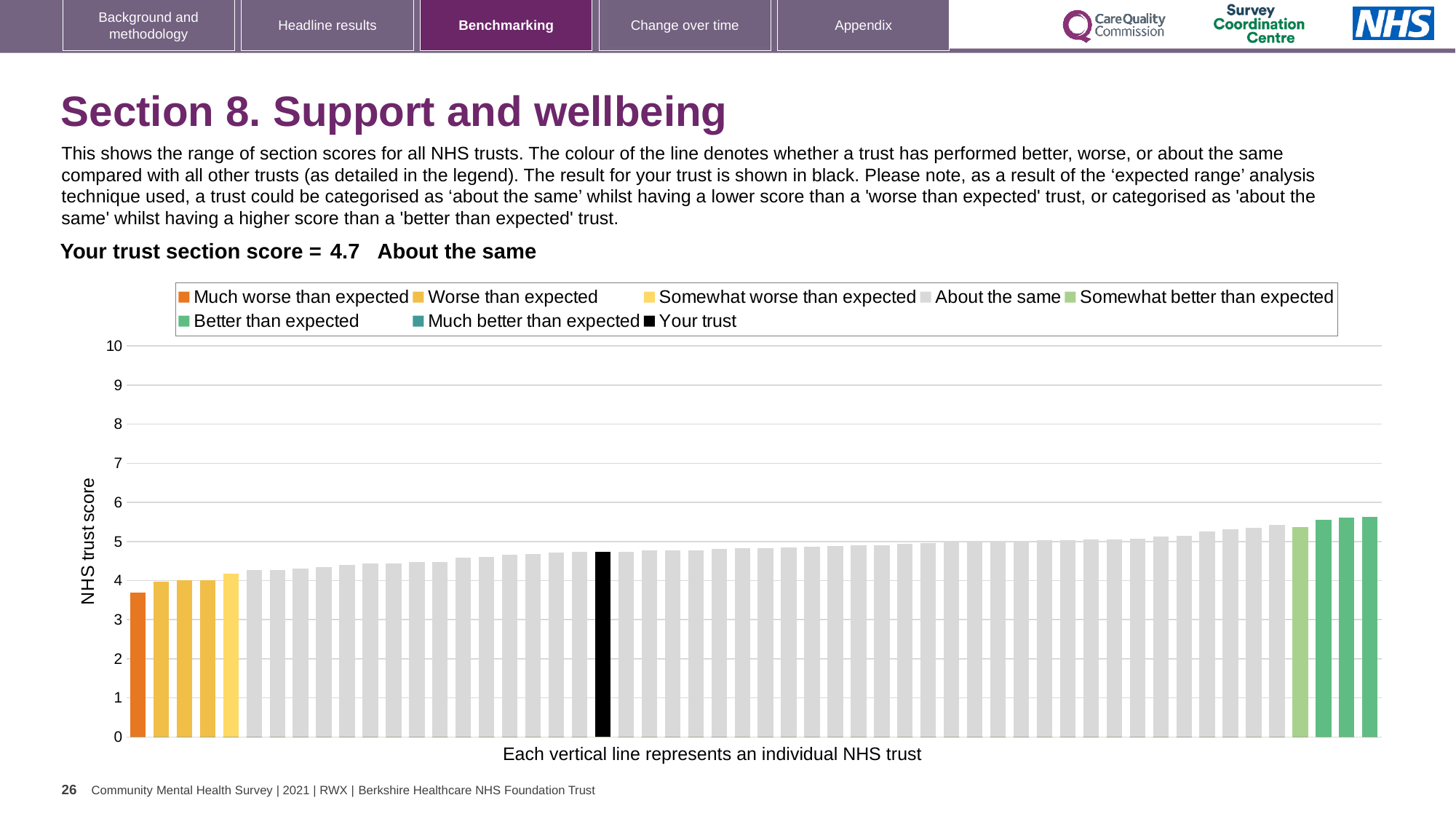
How many bars are coloured as 'Better than expected'? 3 How many entries does the chart legend list? 8 What is the label on the y axis of the chart? NHS trust score Is the value of the black bar (your trust) greater or less than 4? greater What kind of chart is shown on the slide? bar chart Do the bar values rise or fall from left to right along the x axis? rise How many bars are coloured as 'Much worse than expected'? 1 Is the value of the rightmost bar greater or less than 5? greater Is the value of the leftmost (orange) bar greater or less than 4? less What is the section score for your trust? 4.7 Which benchmarking category is your trust placed in for this section? About the same